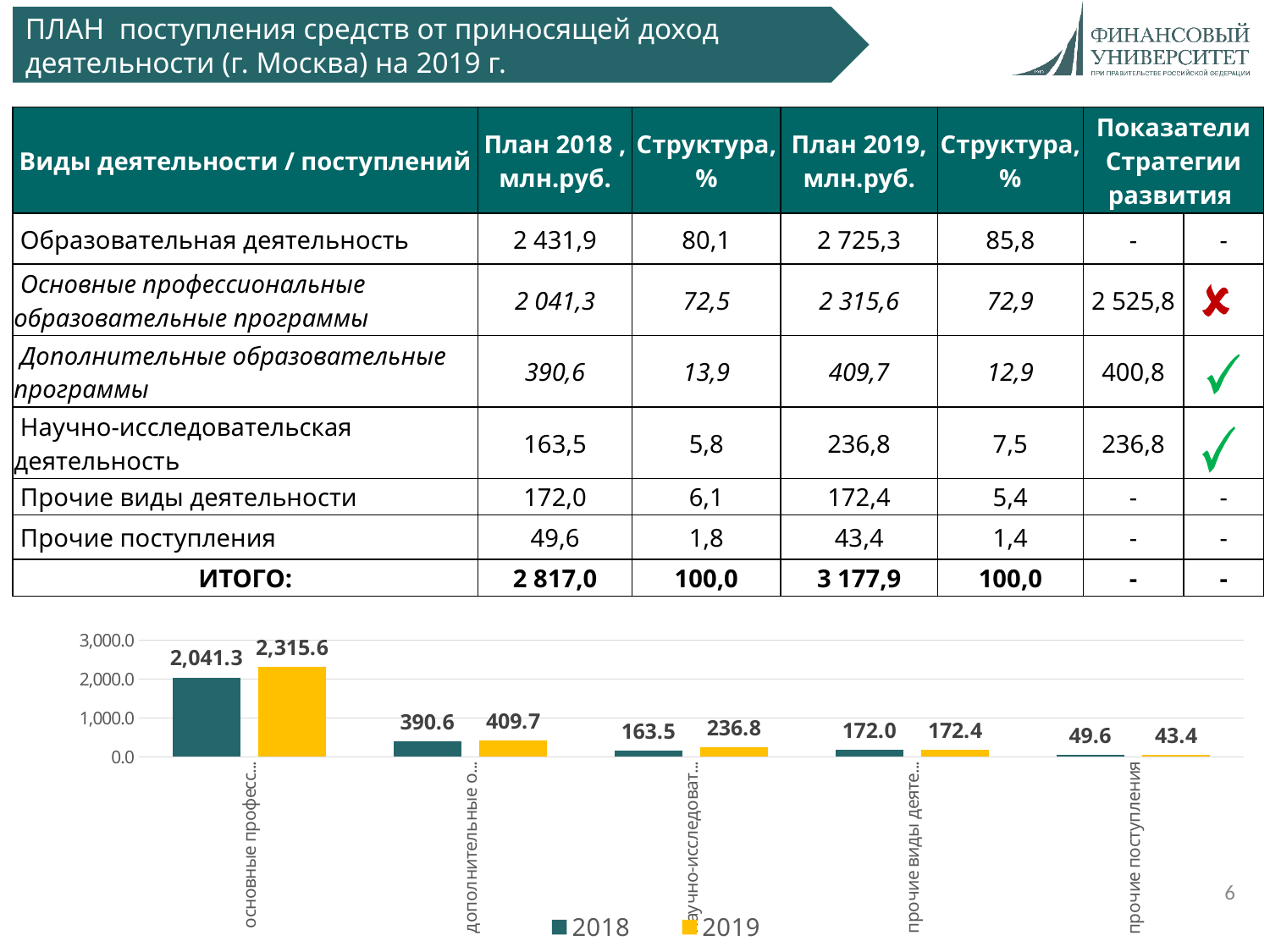
What is the 2019 value for the category 'научно-исследоват...' in the chart? 236.8 Which category has the lowest 2018 value in the chart? прочие поступления What is the difference between the 2019 and 2018 values for the first category ('основные професс...') in the chart? 274.3 Is the 2019 value for the category 'дополнительные о...' greater or less than 1,000.0? less What is the 2018 value for the first category ('основные професс...') in the chart? 2,041.3 What is the 2019 value for the category 'прочие поступления' in the chart? 43.4 How many categories are plotted on the x axis of the chart? 5 What kind of chart is shown at the bottom of the slide? bar chart How many series does the chart legend list? 2 Which category has the highest 2019 value in the chart? основные професс... (основные профессиональные образовательные программы) For the category 'прочие поступления', which is larger in the chart: the 2018 value or the 2019 value? 2018 Which colour represents the 2019 series in the chart? yellow